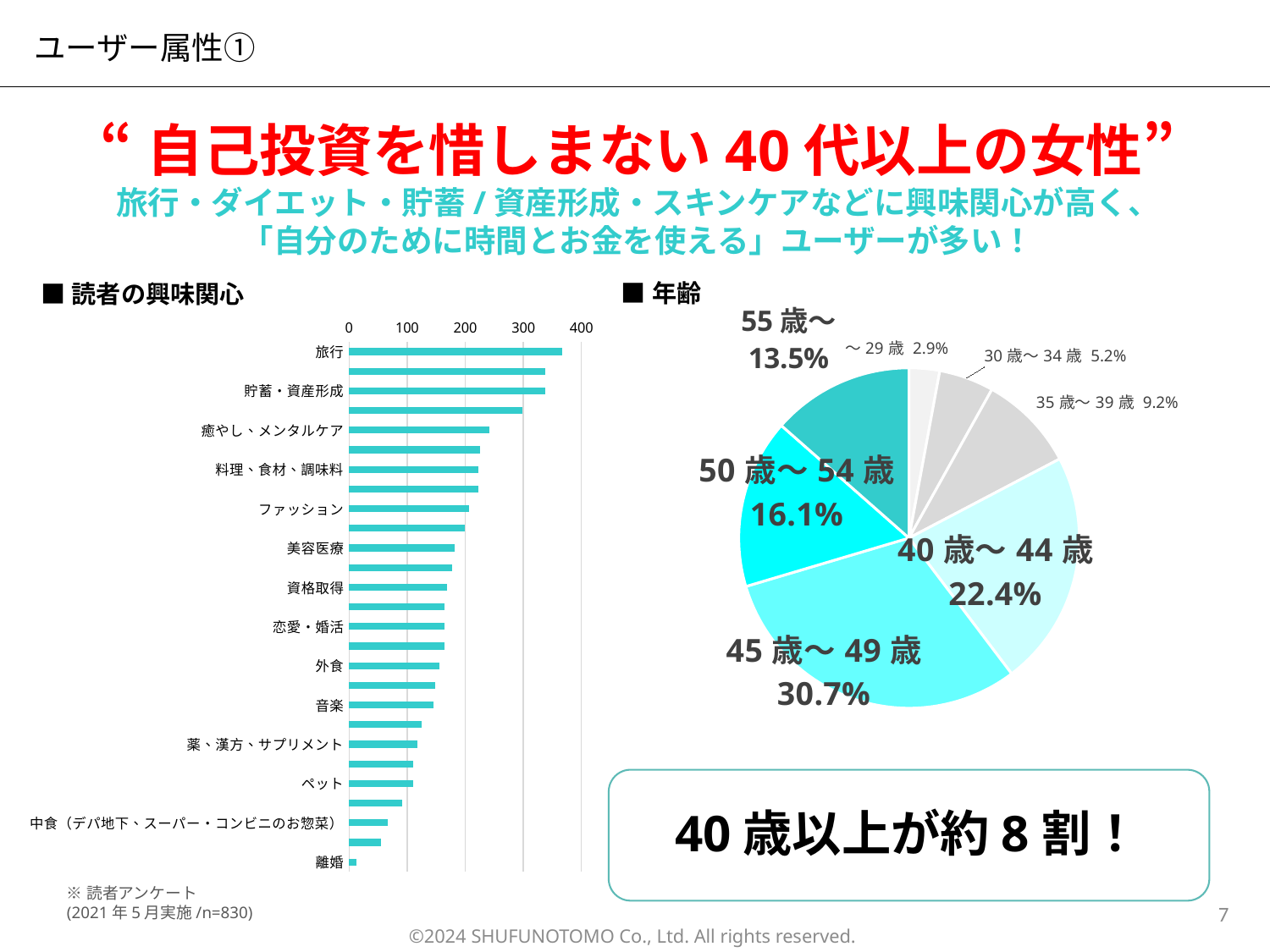
In the 年齢 pie chart, which is larger: 50歳～54歳 or 55歳～? 50歳～54歳 In the 年齢 pie chart, which age group has the smallest share? ～29歳 How many slices does the 年齢 pie chart have? 7 In the 読者の興味関心 bar chart, which category has the highest value? 旅行 What kind of chart is the 読者の興味関心 chart? bar chart In the 読者の興味関心 bar chart, is the value for 旅行 greater or less than 300? greater In the 年齢 pie chart, what is the difference in percentage points between 45歳～49歳 and 40歳～44歳? 8.3 In the 年齢 pie chart, what share is shown for ～29歳? 2.9% In the 年齢 pie chart, what share is shown for 45歳～49歳? 30.7% In the 読者の興味関心 bar chart, is the value for ペット greater or less than 200? less In the 年齢 pie chart, what share is shown for 40歳～44歳? 22.4% In the 年齢 pie chart, which age group has the largest share? 45歳～49歳